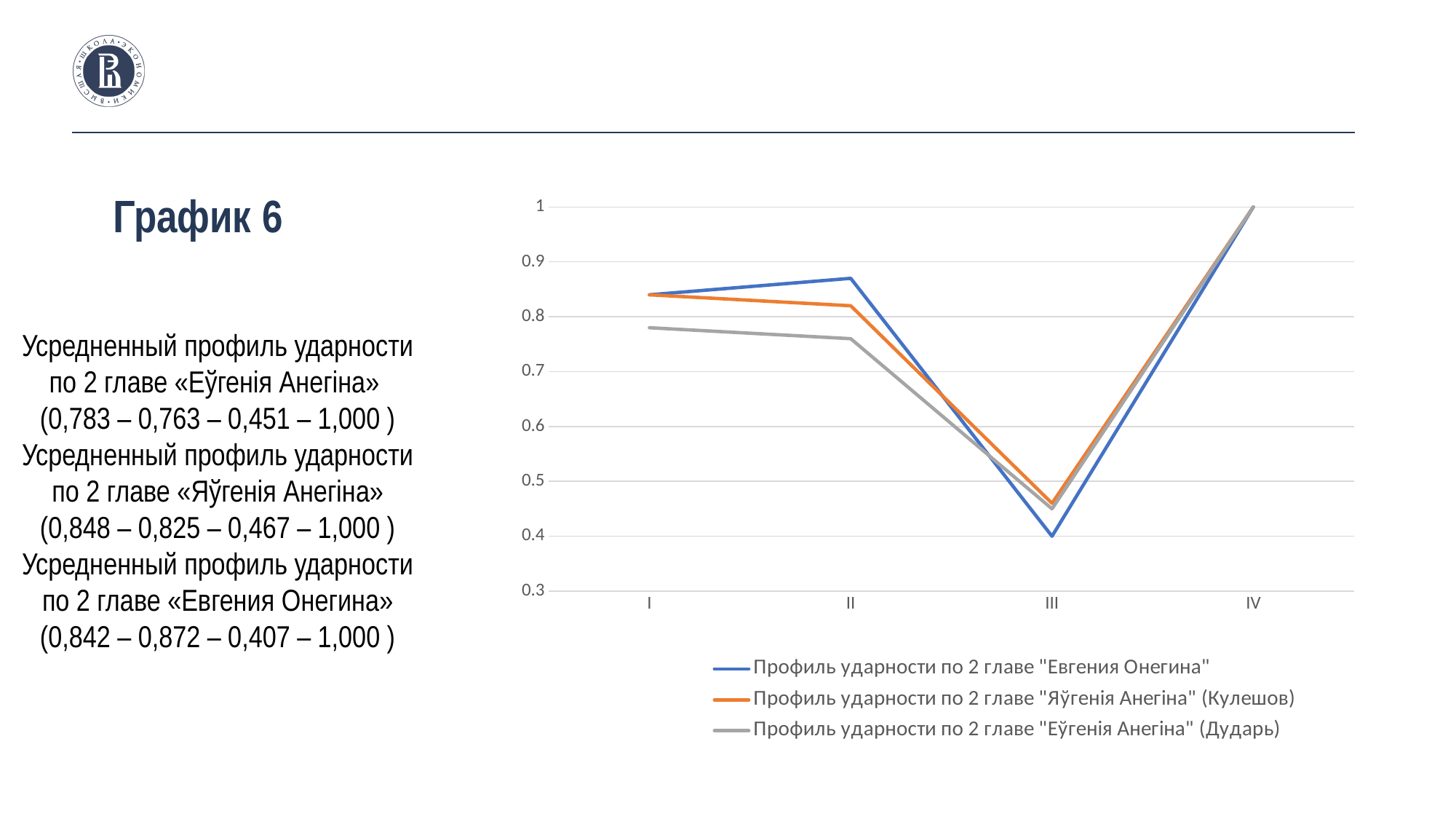
Is the value of the "Евгения Онегина" series at category II greater or less than 0.8? greater How many categories are shown on the x axis of the chart? 4 What value does the series "Профиль ударности по 2 главе "Евгения Онегина"" reach at category IV? 1 At which category do all three series reach their highest value? IV At category II, which series has the higher value: "Евгения Онегина" or "Еўгенія Анегіна" (Дударь)? Евгения Онегина What kind of chart is shown on the slide? line chart Do the series values rise or fall from category II to category III? fall At category III, which series has the higher value: "Евгения Онегина" or "Яўгенія Анегіна" (Кулешов)? Яўгенія Анегіна (Кулешов) Is the value of the "Евгения Онегина" series at category III greater or less than 0.5? less Is the value of the "Еўгенія Анегіна" (Дударь) series at category I greater or less than 0.7? greater At which category does the "Евгения Онегина" series reach its lowest value? III How many series does the chart legend list? 3